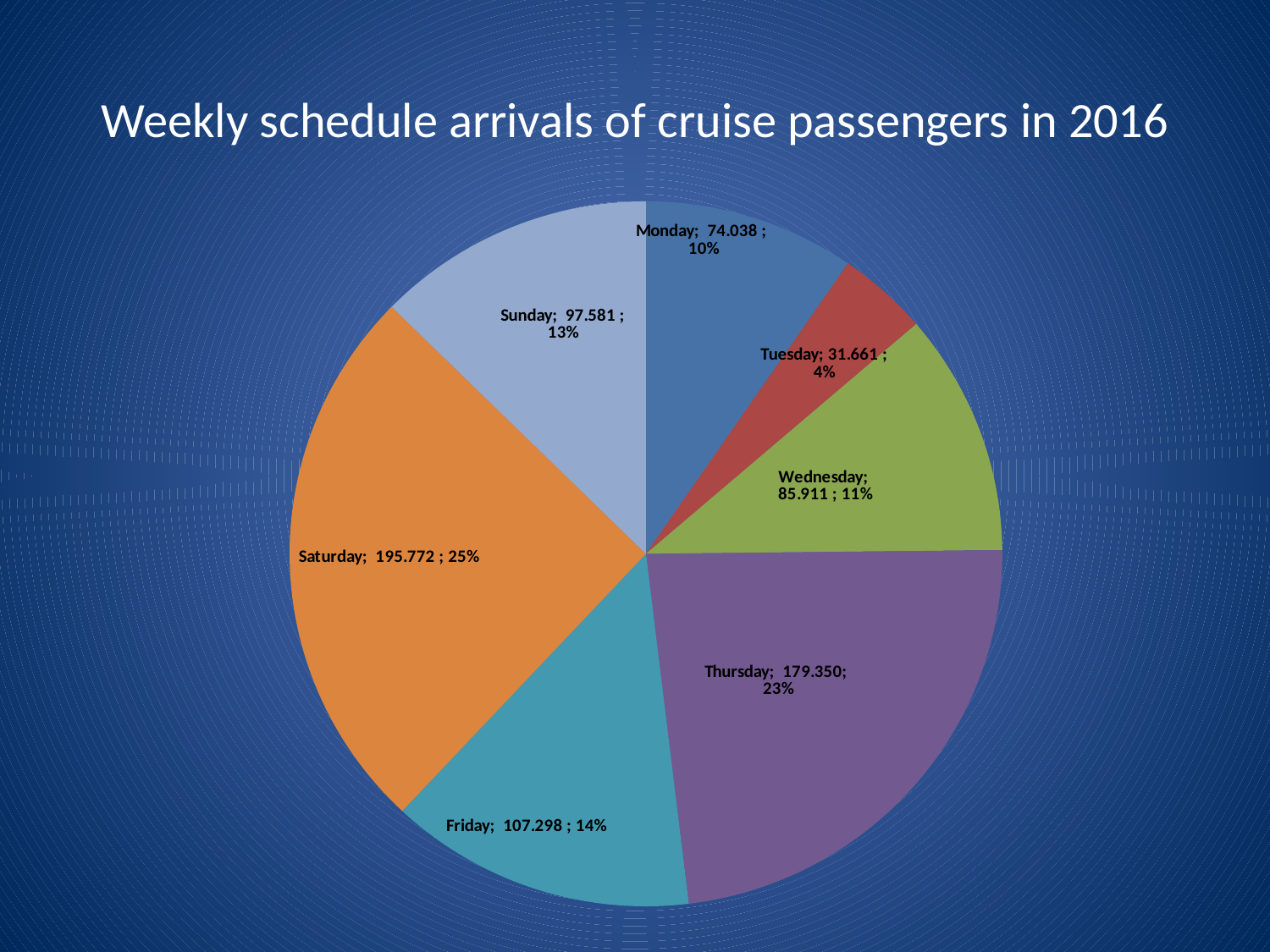
What is the title of the chart? Weekly schedule arrivals of cruise passengers in 2016 Which day has the highest number of cruise passenger arrivals? Saturday What colour is the Saturday slice? Orange What percentage share does Sunday have? 13% What kind of chart is shown on the slide? Pie chart What is the difference between the values for Saturday and Thursday? 16.422 How many categories (days) are shown in the pie chart? 7 Which is larger, the value for Friday or the value for Sunday? Friday What percentage share does Thursday have? 23% What is the value for Tuesday? 31.661 Which day has the lowest number of cruise passenger arrivals? Tuesday What is the value for Saturday? 195.772